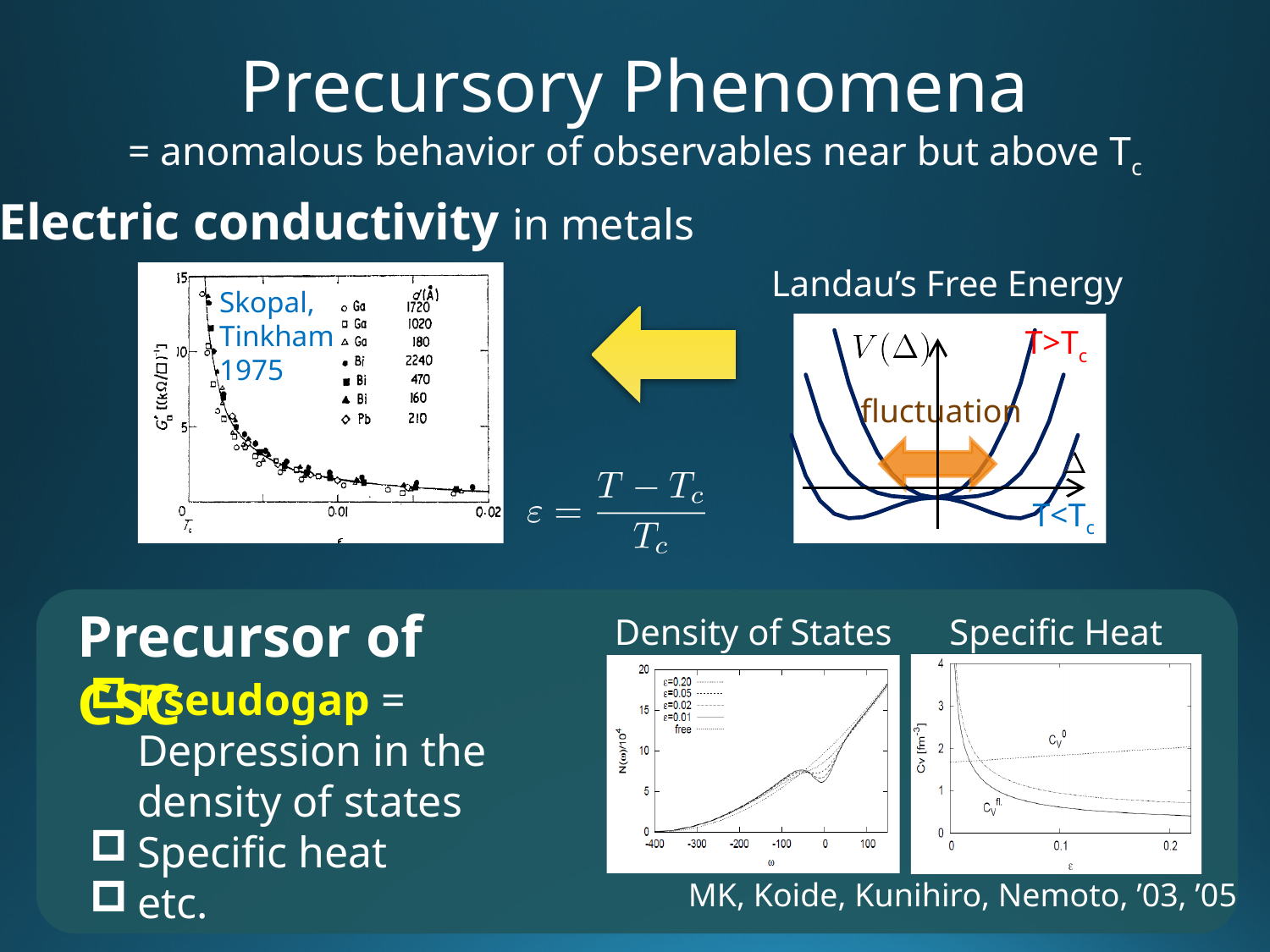
In the Specific Heat chart, does the C_V^fl curve rise or fall as ε increases? fall What is the highest tick value on the y axis of the Electric conductivity chart? 15 In the Specific Heat chart, is the value of C_V^0 at ε=0.1 greater or less than 1? greater In the Electric conductivity chart legend, which material has the largest d(Å) value? Bi (2240) How many entries does the legend of the Density of States chart list? 5 In the Electric conductivity chart legend, what d(Å) value is listed for Pb? 210 In the Electric conductivity chart, does the conductivity rise or fall as ε increases? fall In the Density of States chart legend, which entry has the largest value of ε? ε=0.20 How many data series does the legend of the Electric conductivity chart list? 7 What kind of chart is the Electric conductivity plot (Skopal, Tinkham 1975)? scatter plot with a fitted curve In the Specific Heat chart, which curve is higher at ε=0.2, C_V^0 or C_V^fl? C_V^0 What is the highest tick value on the x axis of the Specific Heat chart? 0.2